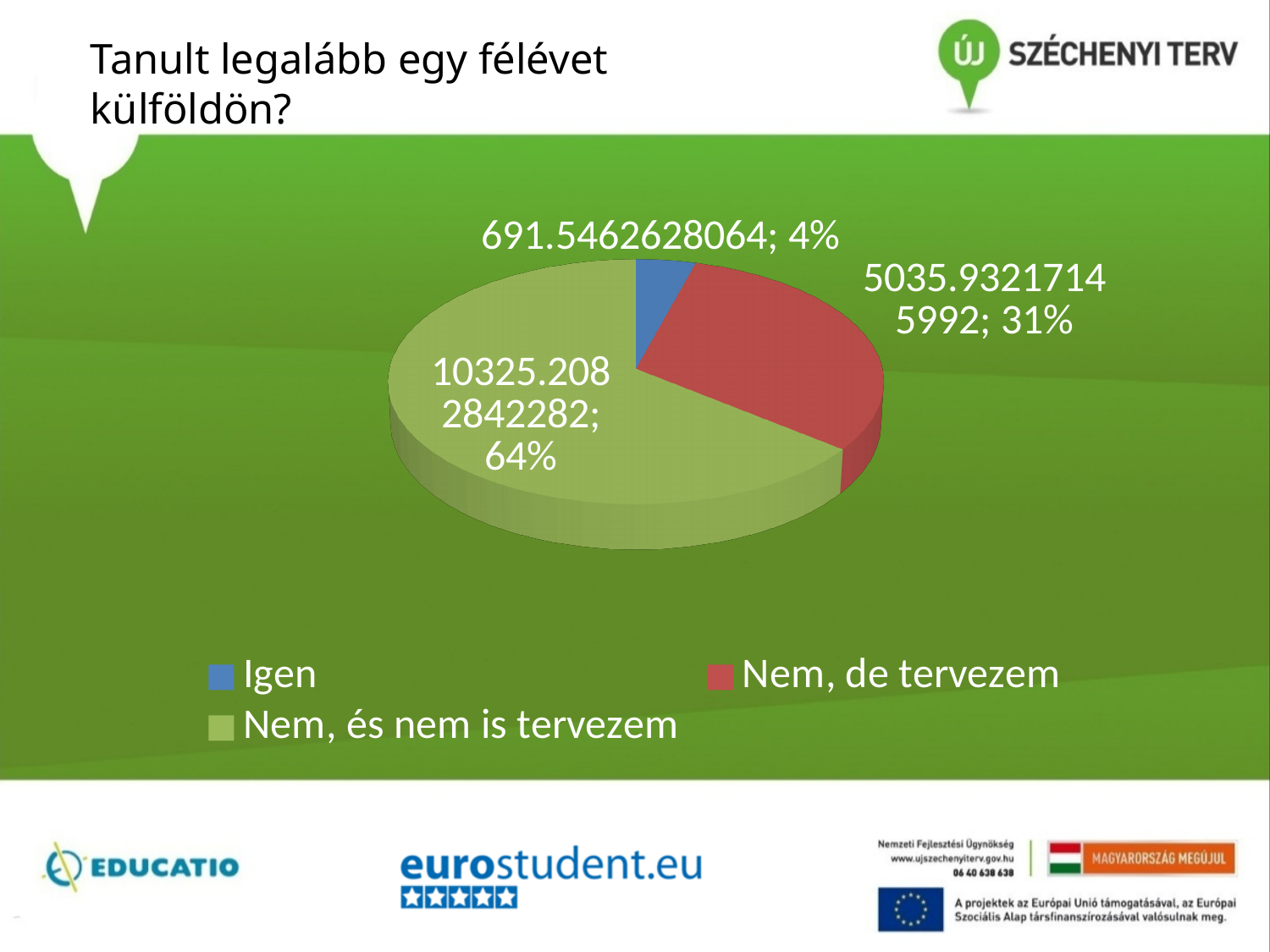
How many entries does the legend of the pie chart list? 3 What share of the pie does the "Igen" slice represent? 4% Which category has the smallest slice of the pie? Igen What share of the pie does the "Nem, de tervezem" slice represent? 31% How many slices does the pie chart have? 3 Which category has the largest slice of the pie? Nem, és nem is tervezem Which slice is larger: "Nem, de tervezem" or "Igen"? Nem, de tervezem What value is printed on the data label for the "Igen" slice? 691.5462628064 What is the title of the slide containing the pie chart? Tanult legalább egy félévet külföldön? What share of the pie does the "Nem, és nem is tervezem" slice represent? 64% By how many percentage points does the share of "Nem, és nem is tervezem" exceed the share of "Nem, de tervezem"? 33 percentage points What kind of chart is shown on the slide? pie chart